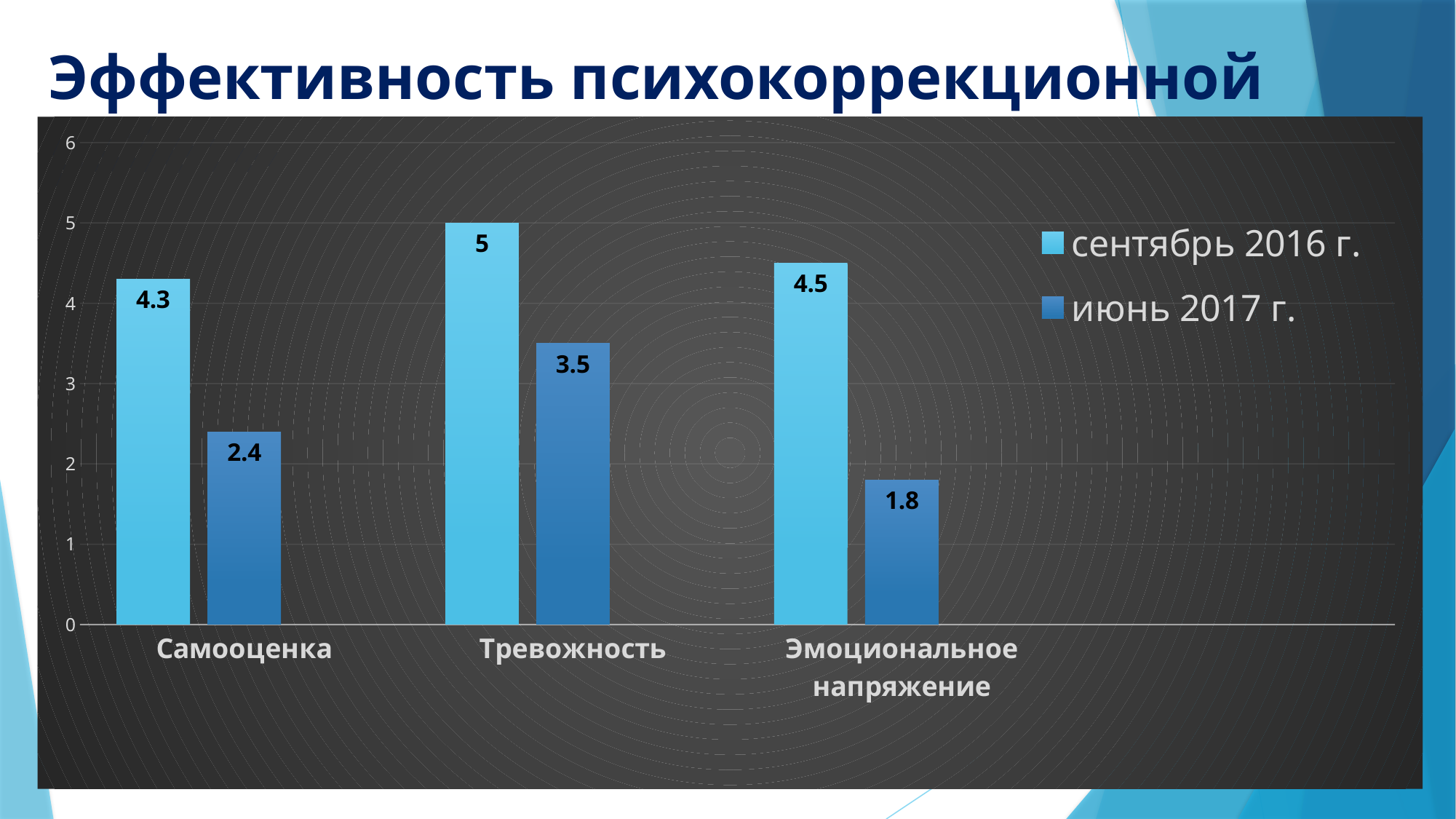
What kind of chart is shown on the slide? Bar chart What is the value for Самооценка in сентябрь 2016 г.? 4.3 Which is larger: the июнь 2017 г. value for Тревожность or the июнь 2017 г. value for Самооценка? Тревожность How many series does the legend list? 2 How many categories are shown on the x axis? 3 Which series is shown in the darker blue colour? июнь 2017 г. Which category has the lowest value in июнь 2017 г.? Эмоциональное напряжение What is the difference between the сентябрь 2016 г. and июнь 2017 г. values for Эмоциональное напряжение? 2.7 What is the difference between the сентябрь 2016 г. and июнь 2017 г. values for Самооценка? 1.9 Which category has the highest value in сентябрь 2016 г.? Тревожность What is the value for Эмоциональное напряжение in июнь 2017 г.? 1.8 What is the value for Тревожность in июнь 2017 г.? 3.5